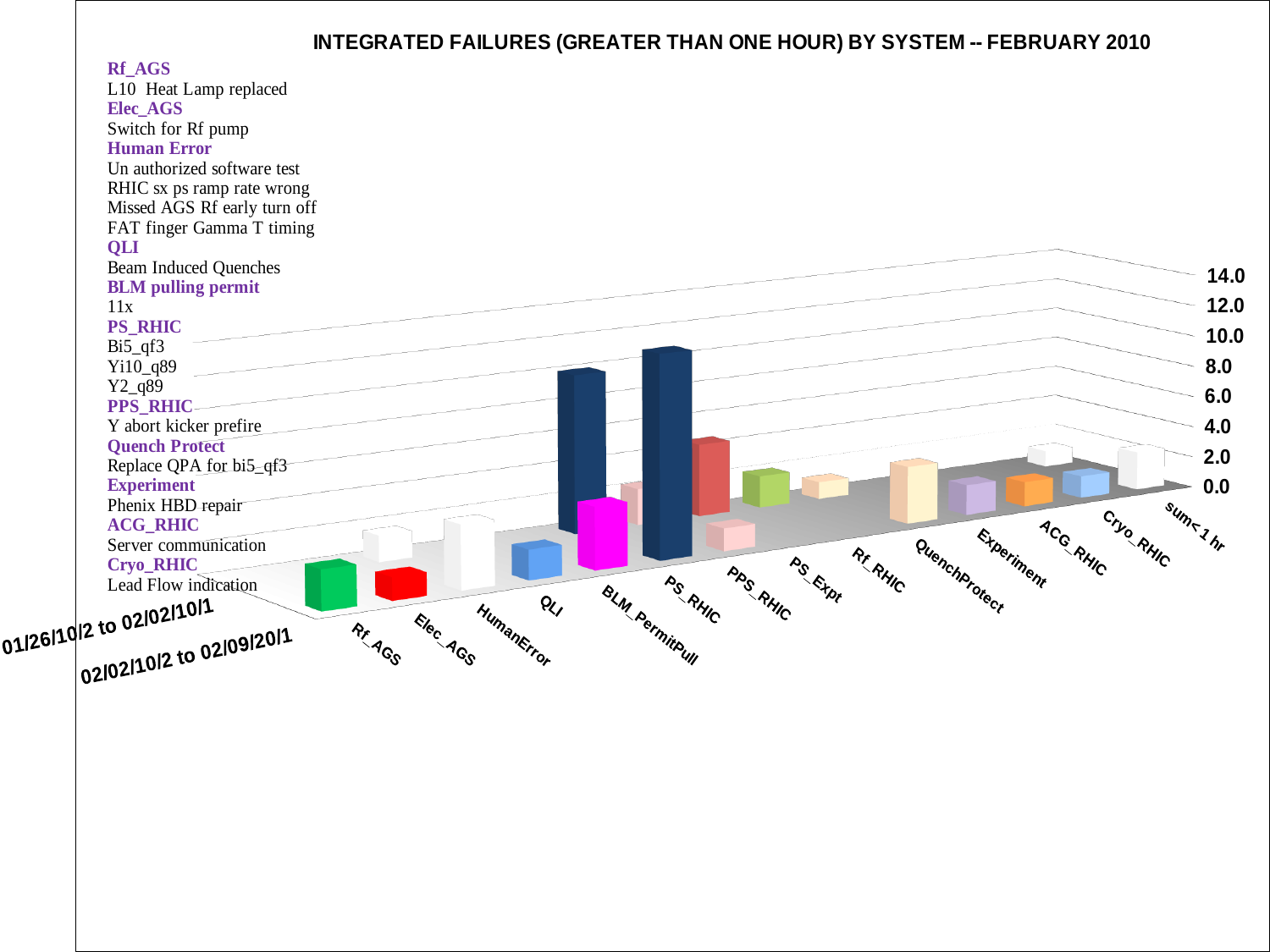
What kind of chart is shown on the slide? bar chart Is the value for Elec_AGS greater or less than 4.0? less Is the tallest bar for PS_RHIC greater or less than 6.0? greater Is the value for Rf_AGS greater or less than 4.0? less Which category has the larger bar, PS_RHIC or Experiment? PS_RHIC How many system categories are shown along the x axis of the chart? 14 How many date-range series (rows of bars) are plotted in the chart? 2 Which category has the larger bar, QLI or Rf_AGS? Rf_AGS What is the title of the chart? INTEGRATED FAILURES (GREATER THAN ONE HOUR) BY SYSTEM -- FEBRUARY 2010 What is the highest value shown on the vertical axis of the chart? 14.0